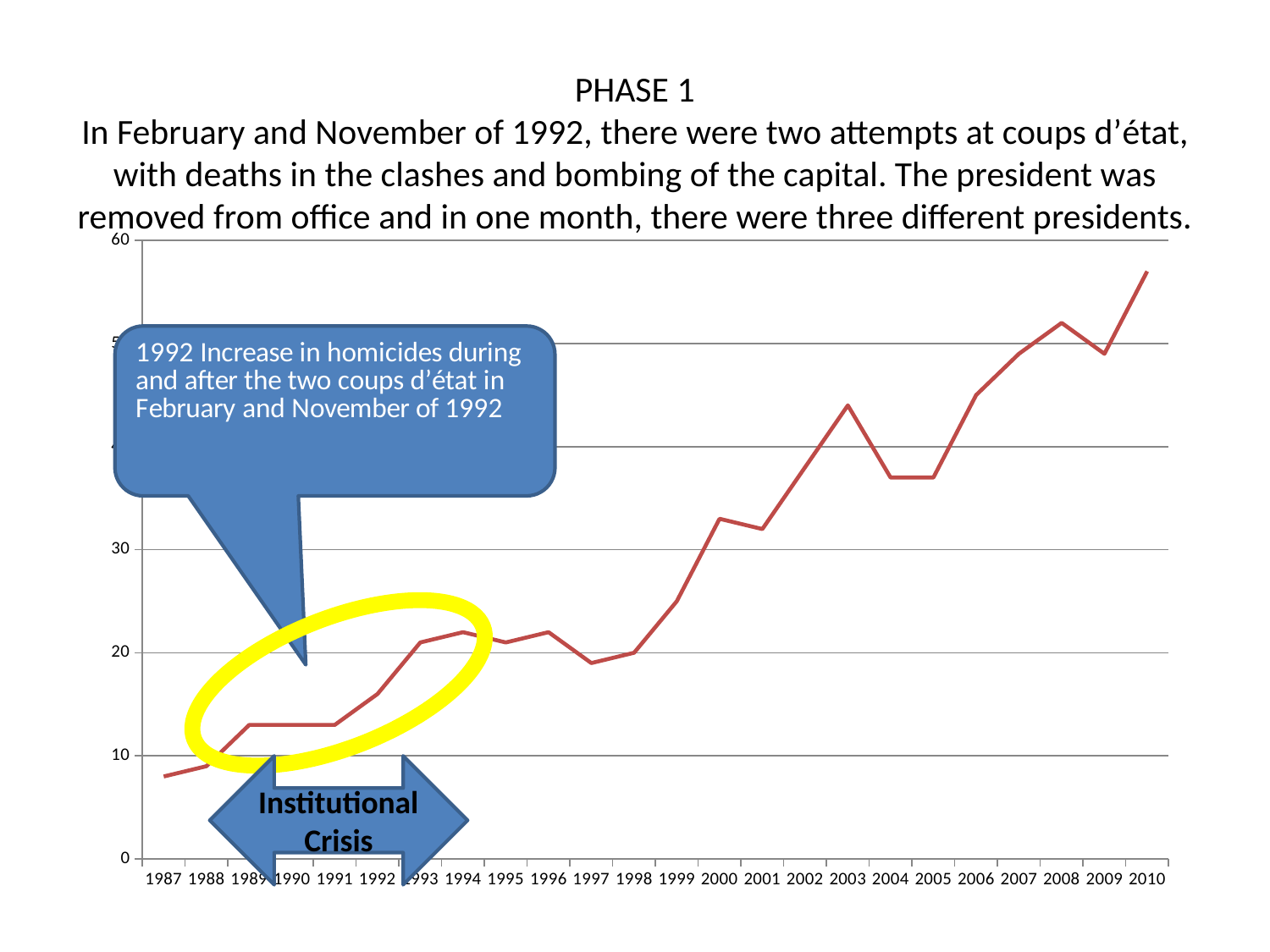
Is the value for 2010 greater or less than 50? greater What kind of chart is shown on the slide? line chart Is the value for 1997 greater or less than 20? less Is the value for 1987 greater or less than 10? less What label is written on the blue double-headed arrow below the chart? Institutional Crisis Overall, do the values rise or fall from 1987 to 2010? rise Which year has the larger value, 2003 or 2004? 2003 Which year has the highest value on the chart? 2010 How many years are plotted along the x axis of the chart? 24 Which year has the lowest value on the chart? 1987